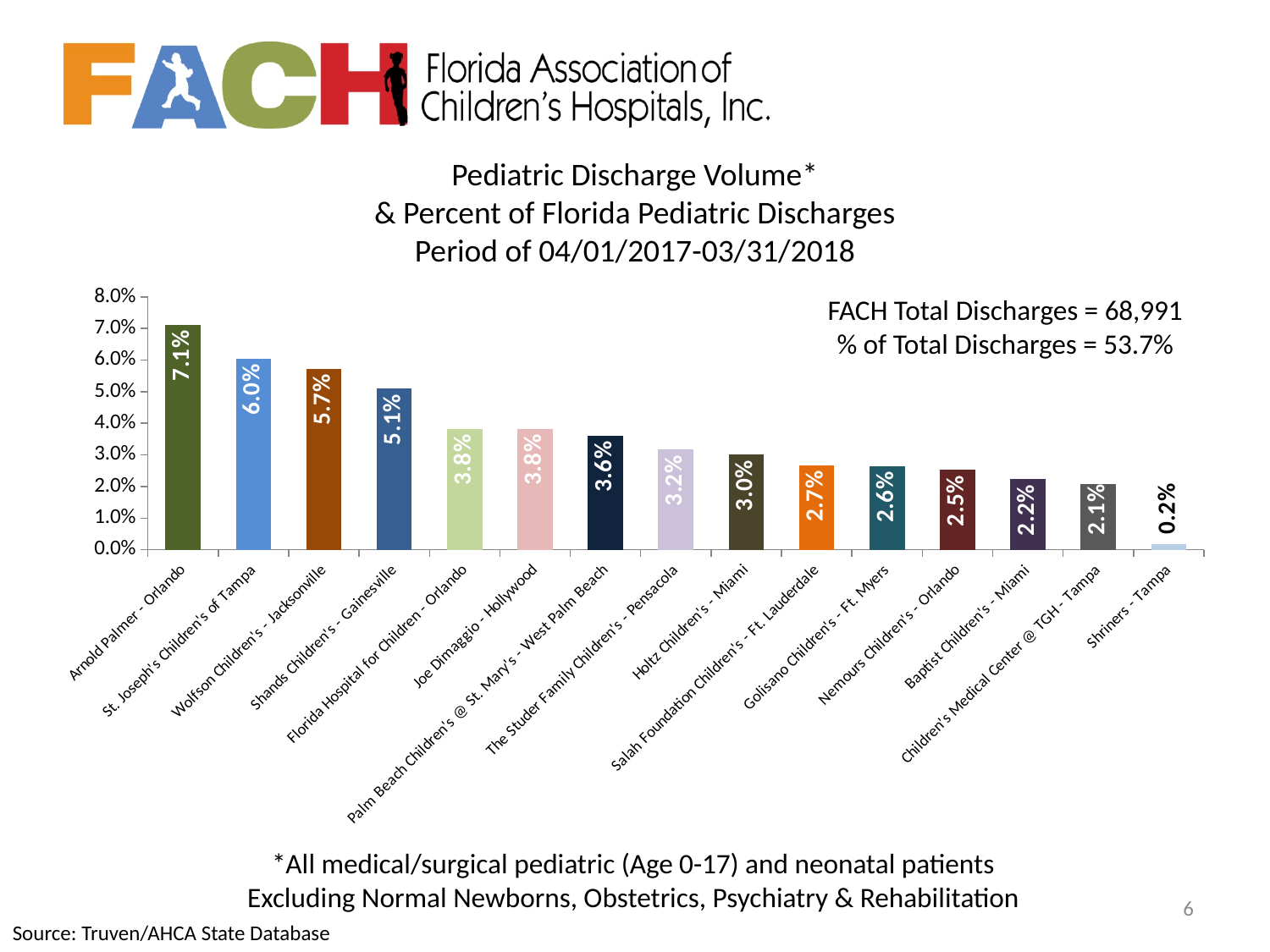
Which is larger, the value for Shands Children's - Gainesville or the value for Palm Beach Children's @ St. Mary's - West Palm Beach? Shands Children's - Gainesville Which hospital has the highest percentage of Florida pediatric discharges? Arnold Palmer - Orlando How many hospitals are shown on the chart? 15 What percentage of Florida pediatric discharges is shown for Arnold Palmer - Orlando? 7.1% Which hospital has the lowest percentage of Florida pediatric discharges? Shriners - Tampa What kind of chart is shown on the slide? bar chart What is the FACH Total Discharges figure stated on the chart? 68,991 Is the value for Nemours Children's - Orlando greater or less than 3.0%? less What value is shown for Holtz Children's - Miami? 3.0% Do the values generally rise or fall from left to right across the chart? fall What value is shown for Shriners - Tampa? 0.2% What is the difference between the values for St. Joseph's Children's of Tampa and Wolfson Children's - Jacksonville? 0.3%